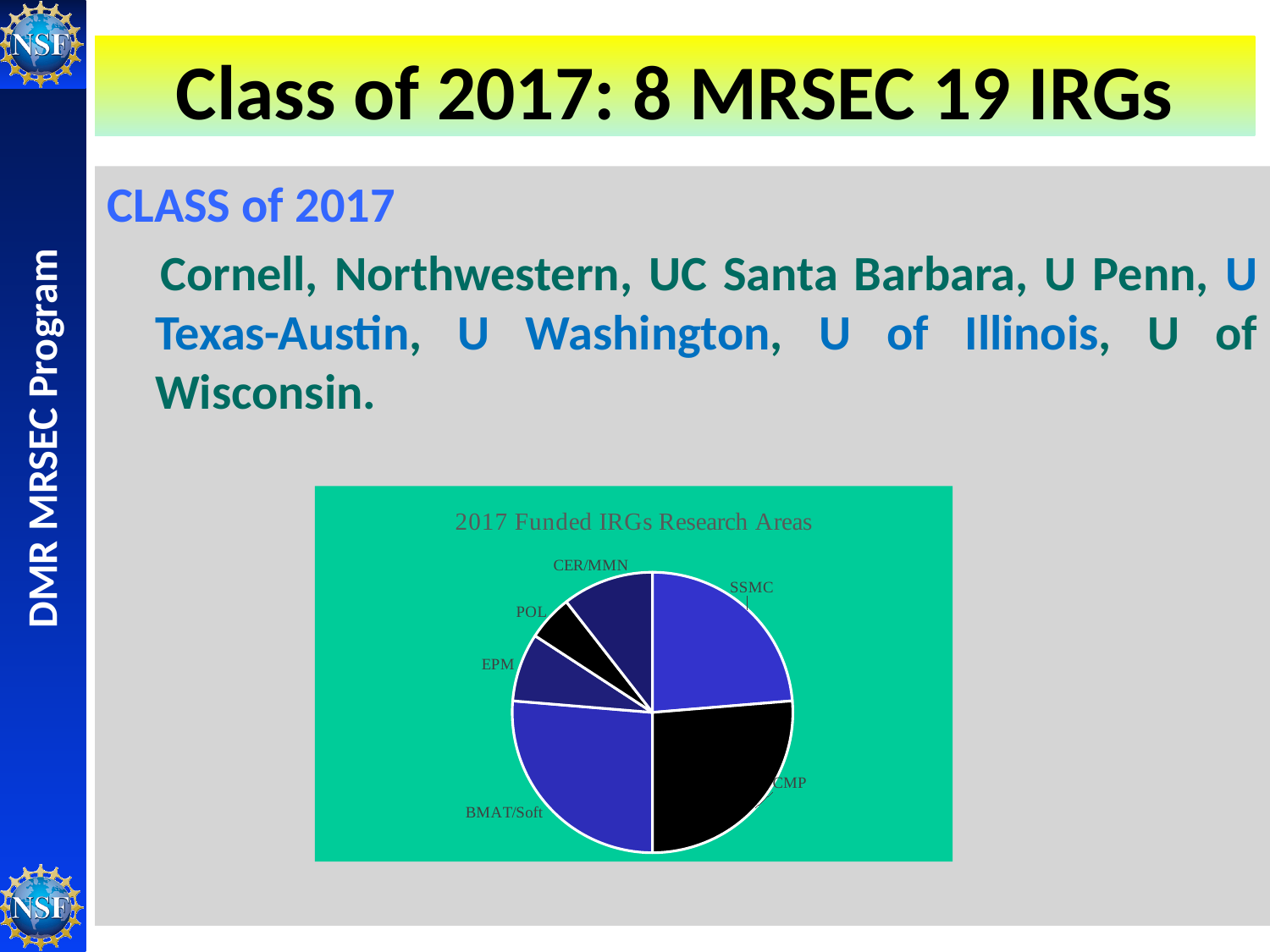
What is the title of the chart on the slide? 2017 Funded IRGs Research Areas How many slices does the pie chart have? 6 Which slice is larger in the pie chart, BMAT/Soft or CER/MMN? BMAT/Soft Which slice is larger in the pie chart, CMP or POL? CMP What kind of chart is shown on the slide? pie chart What colour is the CMP slice in the pie chart? black Which slice is larger in the pie chart, CMP or EPM? CMP Which research area has the smallest slice in the pie chart? POL